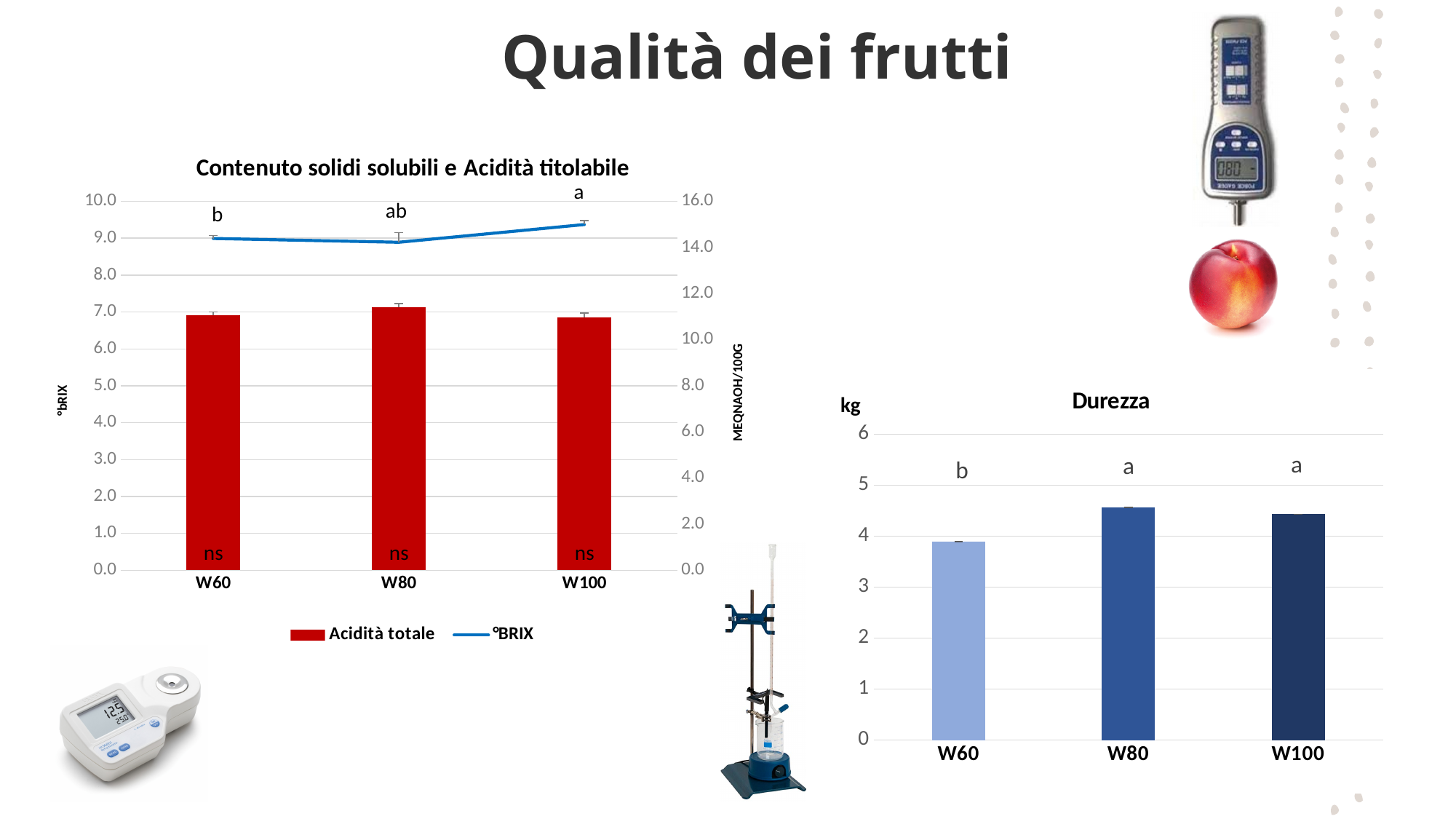
How many categories are shown on the x axis of the 'Durezza' chart? 3 In the 'Durezza' chart, which category has the lowest bar? W60 In the 'Contenuto solidi solubili e Acidità titolabile' chart, is the 'Acidità totale' bar for W60 greater or less than 6.0 on the left axis? greater In the 'Durezza' chart, is the value for W80 greater or less than 4? greater In the 'Durezza' chart, which is larger, the value for W60 or the value for W80? W80 In the 'Durezza' chart, is the value for W60 greater or less than 4? less In the 'Contenuto solidi solubili e Acidità titolabile' chart, which category has the tallest 'Acidità totale' bar? W80 How many series does the legend of the 'Contenuto solidi solubili e Acidità titolabile' chart list? 2 What kind of chart is the 'Durezza' chart? bar chart In the 'Contenuto solidi solubili e Acidità titolabile' chart, what colour are the 'Acidità totale' bars? red In the 'Contenuto solidi solubili e Acidità titolabile' chart, which category has the highest point on the °BRIX line? W100 What unit is shown above the y axis of the 'Durezza' chart? kg